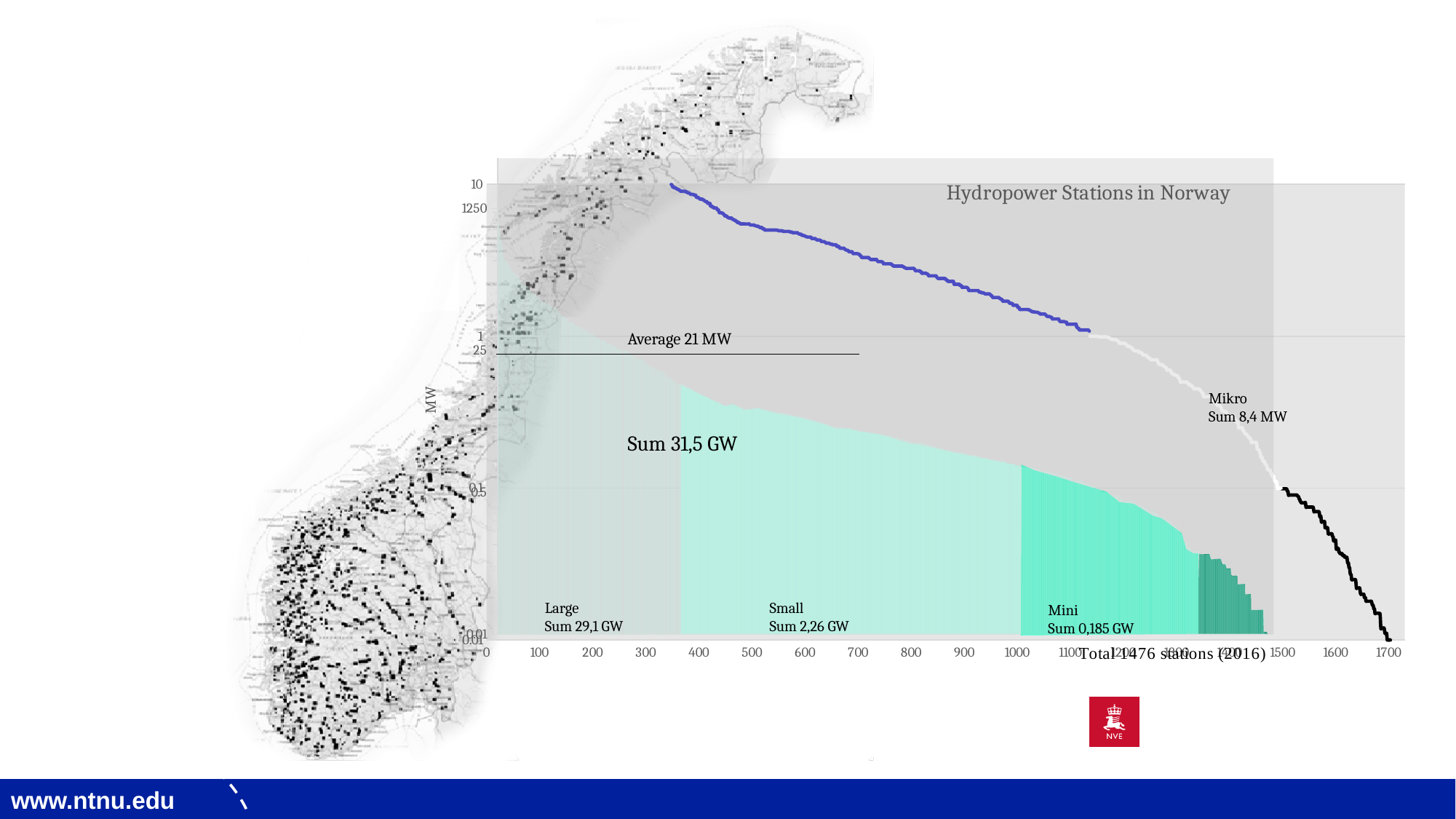
What is the title of the chart? Hydropower Stations in Norway Which category has the smallest capacity sum? Mikro How many hydropower stations in total does the chart report for 2016? 1476 Which category has the largest capacity sum? Large What is the sum of capacity for the Mikro category? 8,4 MW What is the total capacity sum shown on the chart? 31,5 GW What is the sum of capacity for the Small category? 2,26 GW What is the average station capacity shown on the chart? 21 MW What is the sum of capacity for the Mini category? 0,185 GW Which has a larger capacity sum, Small or Mini? Small What is the sum of capacity for the Large category? 29,1 GW Does the plotted capacity rise or fall as the station number increases along the x axis? fall